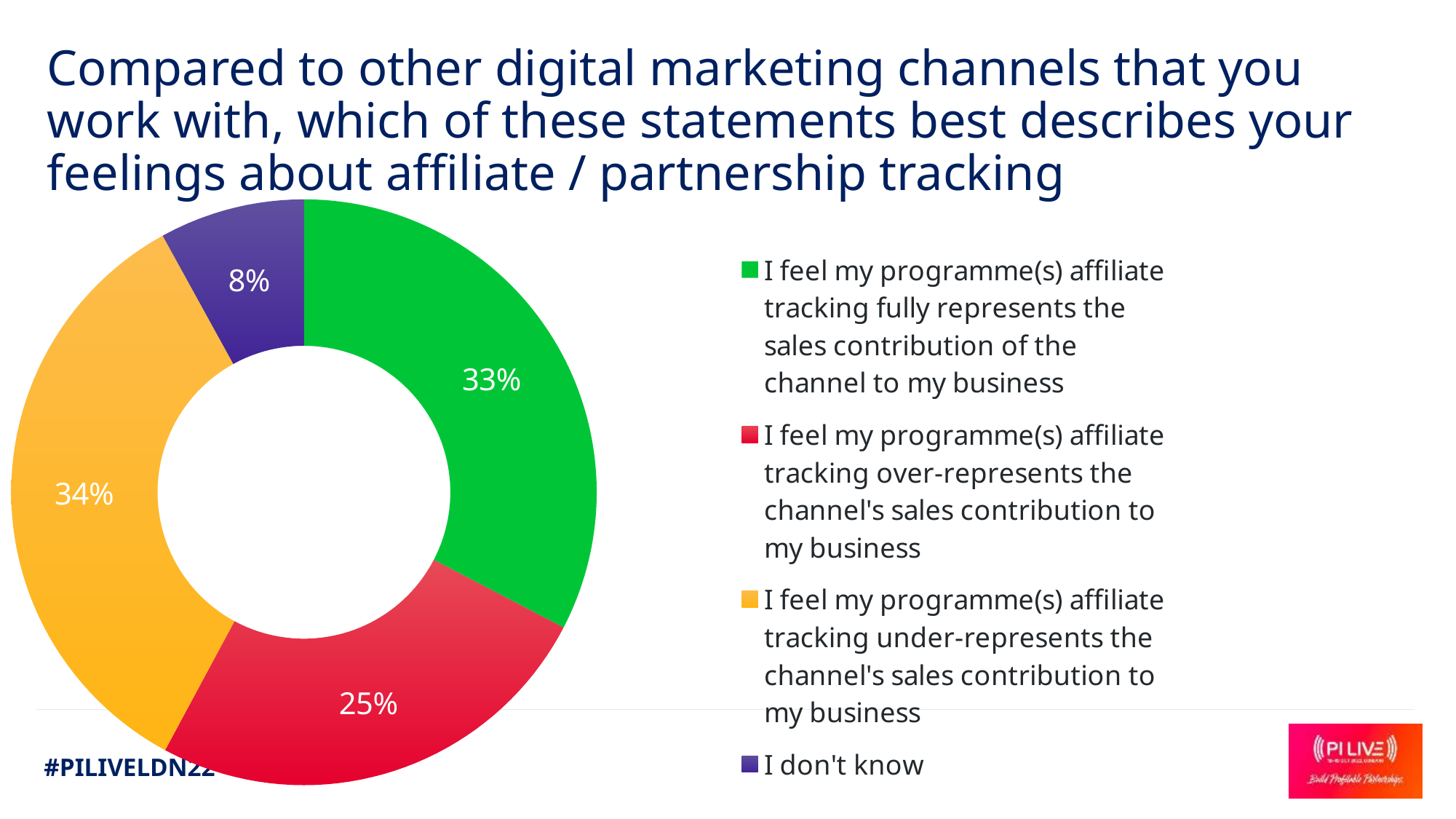
What percentage of respondents answered 'I don't know'? 8% How many slices does the chart have? 4 What is the difference in percentage points between the 'under-represents' slice and the 'over-represents' slice? 9 Which response has the smallest share of the chart? I don't know What colour is the slice for 'I don't know'? purple What percentage of respondents said their affiliate tracking fully represents the channel's sales contribution? 33% Which is larger: the share for 'fully represents' or the share for 'over-represents'? fully represents Which response has the largest share of the chart? I feel my programme(s) affiliate tracking under-represents the channel's sales contribution to my business What percentage of respondents said their affiliate tracking over-represents the channel's sales contribution? 25% What kind of chart is shown on the slide? doughnut chart What percentage of respondents said their affiliate tracking under-represents the channel's sales contribution? 34% What is the combined share of the 'fully represents' and 'over-represents' slices? 58%